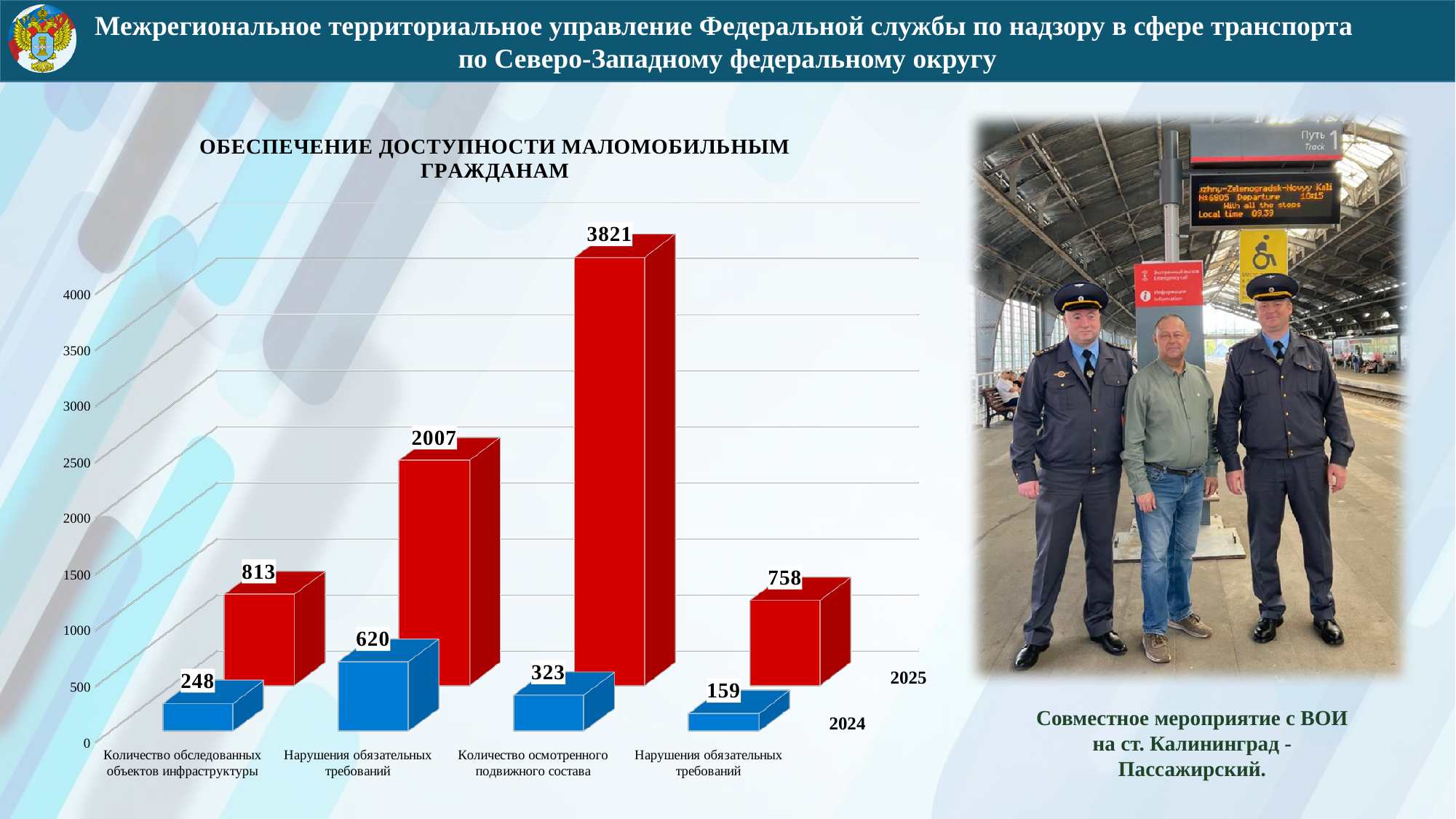
Which is larger: the 2024 value for "Количество осмотренного подвижного состава" or the 2024 value for the second category "Нарушения обязательных требований"? Нарушения обязательных требований (620) What is the 2025 value for "Количество осмотренного подвижного состава"? 3821 What is the 2024 value for the fourth (rightmost) category, "Нарушения обязательных требований"? 159 Which category has the lowest 2024 value? Нарушения обязательных требований (rightmost category) What is the 2025 value for the second category, "Нарушения обязательных требований"? 2007 What type of chart is shown on the slide? bar chart Which category has the highest 2025 value? Количество осмотренного подвижного состава What is the difference between the 2025 and 2024 values for "Количество обследованных объектов инфраструктуры"? 565 What is the chart's title? ОБЕСПЕЧЕНИЕ ДОСТУПНОСТИ МАЛОМОБИЛЬНЫМ ГРАЖДАНАМ What is the 2024 value for "Количество обследованных объектов инфраструктуры"? 248 How many categories are shown on the x axis of the chart? 4 How many series does the chart show? 2